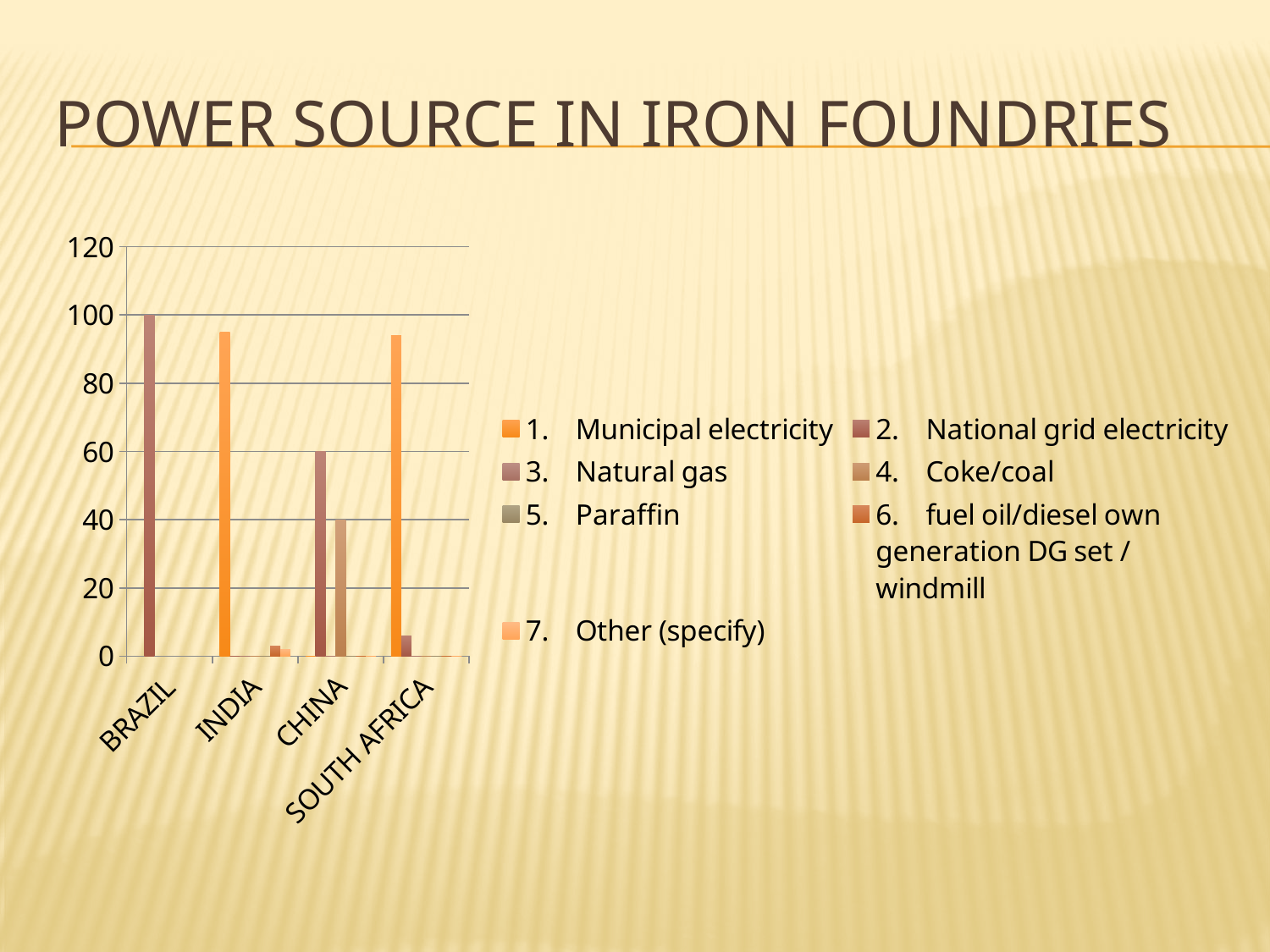
What is the value for Natural gas in China? 0 Is the value for Municipal electricity in India greater or less than 80? greater How many series does the chart's legend list? 7 What is the value for Coke/coal in China? 40 What is the difference between Natural gas and Coke/coal in China? 40 What is the value for National grid electricity in Brazil? 100 How many countries are shown on the x axis of the chart? 4 What is the title of the slide containing the chart? POWER SOURCE IN IRON FOUNDRIES What kind of chart is shown on the slide? Bar chart Is the value for Municipal electricity in South Africa greater or less than 80? greater Is the value for Natural gas in South Africa greater or less than 20? less Which is larger: National grid electricity in Brazil or Natural gas in China? National grid electricity in Brazil